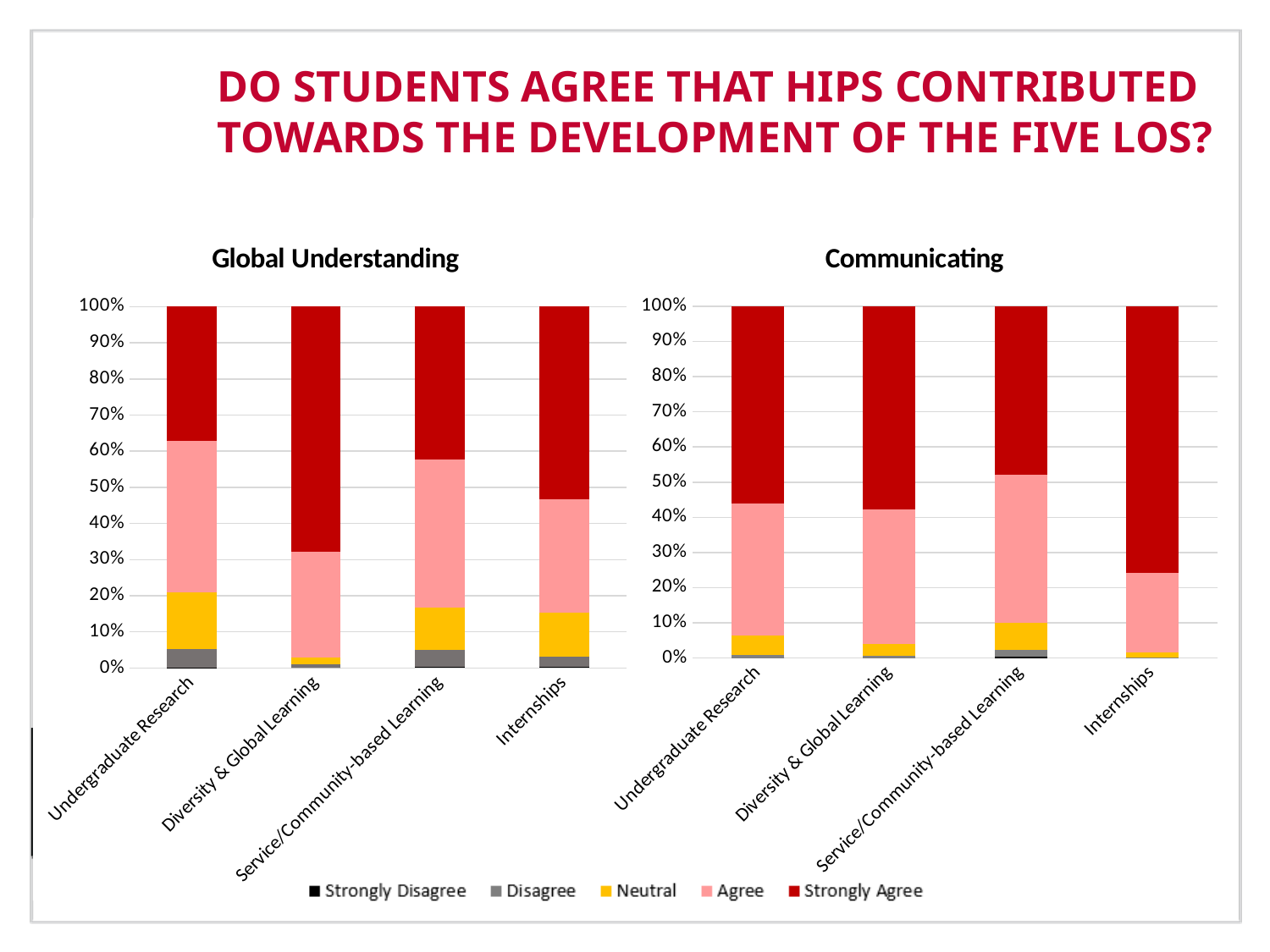
In the Communicating chart, is the Strongly Agree share for Internships greater or less than 70%? greater What is the total height of the stacked bar for Internships in the Global Understanding chart? 100% How many series does the legend list for the charts? 5 In the Communicating chart, which category has the largest Strongly Agree segment? Internships In the Global Understanding chart, is the Strongly Agree share for Diversity & Global Learning greater or less than 60%? greater In the Global Understanding chart, which has the larger Strongly Agree segment: Undergraduate Research or Diversity & Global Learning? Diversity & Global Learning In the Communicating chart, which has the larger Agree segment: Service/Community-based Learning or Internships? Service/Community-based Learning In the Global Understanding chart, which category has the largest Strongly Agree segment? Diversity & Global Learning In the Communicating chart, is the Agree share for Internships greater or less than 30%? less How many categories are shown on the x axis of the Communicating chart? 4 In the Communicating chart, which category has the smallest Strongly Agree segment? Service/Community-based Learning What kind of chart is the Global Understanding chart? stacked bar chart